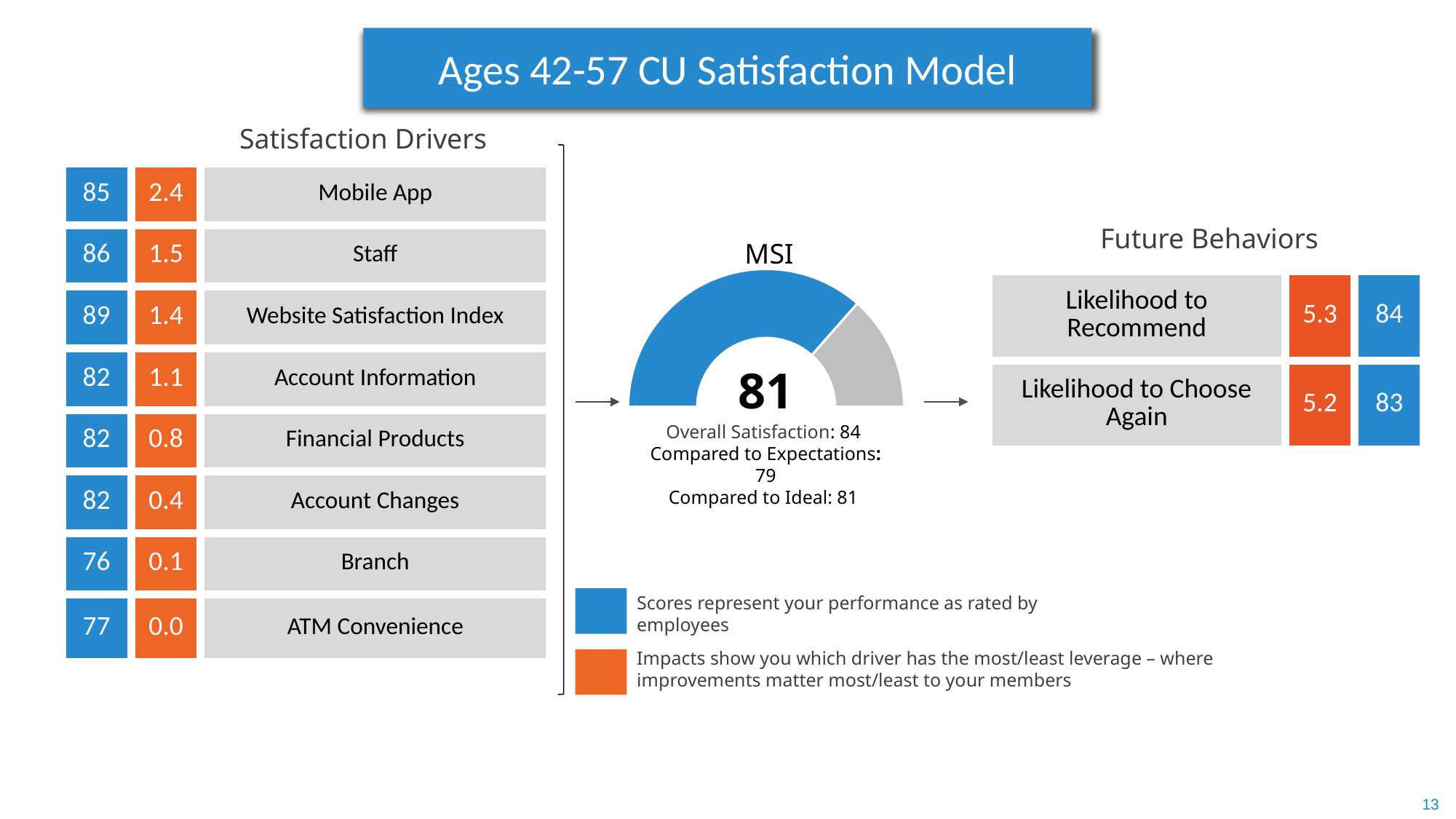
In the Future Behaviors section, which has the higher score: Likelihood to Recommend or Likelihood to Choose Again? Likelihood to Recommend What kind of chart is used to show the MSI score? Gauge chart What is the title of the gauge chart in the centre of the slide? MSI What value does the MSI gauge chart display? 81 What is the Compared to Ideal value shown below the MSI gauge? 81 In the Satisfaction Drivers list, which driver has the lowest score (blue box)? Branch What is the Compared to Expectations value shown below the MSI gauge? 79 What is the difference between the Website Satisfaction Index score (89) and the Branch score (76)? 13 How many satisfaction drivers are listed on the slide? 8 What is the Overall Satisfaction value shown below the MSI gauge? 84 In the Satisfaction Drivers list, which driver has the highest score (blue box)? Website Satisfaction Index In the Satisfaction Drivers list, what is the impact value (orange box) for Mobile App? 2.4